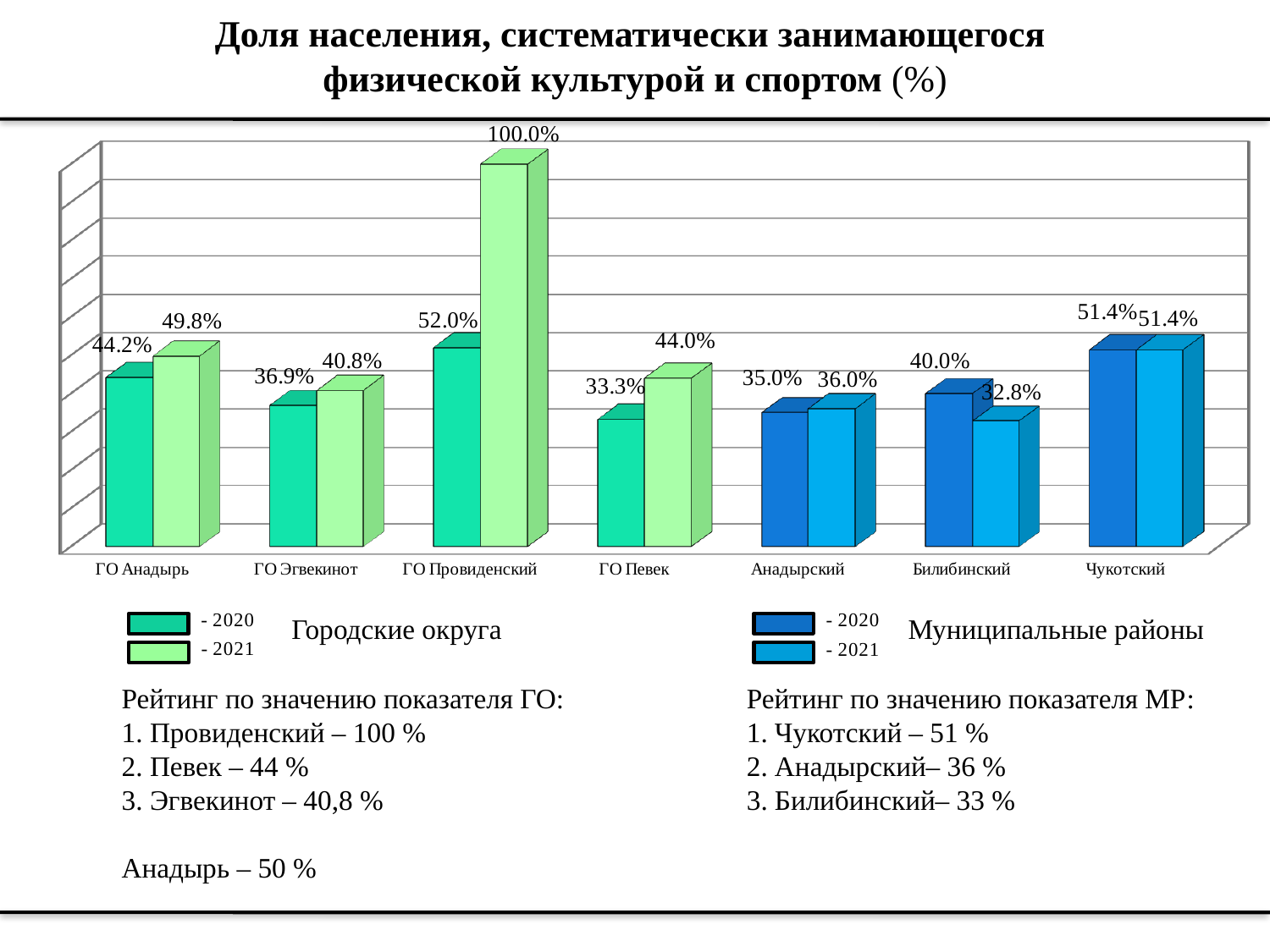
How many categories are shown on the x axis? 7 Which category has the lowest 2020 value? ГО Певек What is the 2020 value for Чукотский? 51.4% What is the difference between the 2021 values for ГО Анадырь and ГО Эгвекинот? 9.0% What is the 2021 value for Билибинский? 32.8% What is the difference between the 2021 and 2020 values for ГО Провиденский? 48.0% Which category has the highest 2021 value? ГО Провиденский What is the 2020 value for ГО Певек? 33.3% Which is larger for Билибинский: the 2020 value or the 2021 value? 2020 Which two years does the legend list? 2020 and 2021 What is the 2021 value for ГО Анадырь? 49.8% What kind of chart is shown on the slide? bar chart